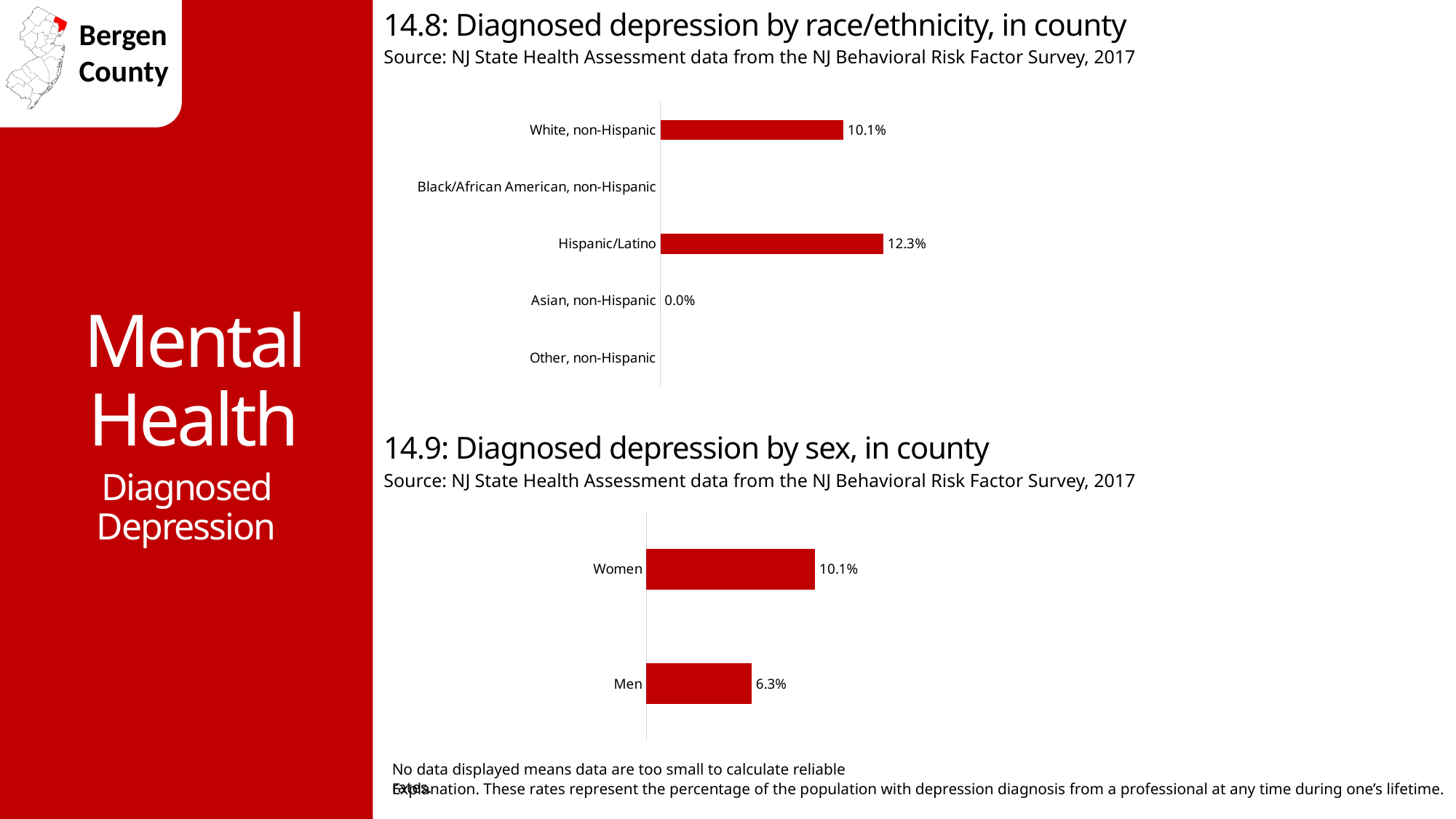
In the chart '14.8: Diagnosed depression by race/ethnicity, in county', how many race/ethnicity categories are listed on the axis? 5 In the chart '14.8: Diagnosed depression by race/ethnicity, in county', what is the difference between the Hispanic/Latino and White, non-Hispanic values? 2.2% In the chart '14.9: Diagnosed depression by sex, in county', what is the difference between the Women and Men values? 3.8% In the chart '14.8: Diagnosed depression by race/ethnicity, in county', what is the value for White, non-Hispanic? 10.1% In the chart '14.8: Diagnosed depression by race/ethnicity, in county', what value is shown for Asian, non-Hispanic? 0.0% In the chart '14.8: Diagnosed depression by race/ethnicity, in county', which is larger, the value for White, non-Hispanic or Hispanic/Latino? Hispanic/Latino In the chart '14.9: Diagnosed depression by sex, in county', which group has the lower value? Men What type of chart is '14.9: Diagnosed depression by sex, in county'? Bar chart In the chart '14.9: Diagnosed depression by sex, in county', what is the value for Men? 6.3% In the chart '14.9: Diagnosed depression by sex, in county', what is the value for Women? 10.1% In the chart '14.8: Diagnosed depression by race/ethnicity, in county', what is the value for Hispanic/Latino? 12.3% In the chart '14.8: Diagnosed depression by race/ethnicity, in county', which race/ethnicity group has the highest value? Hispanic/Latino